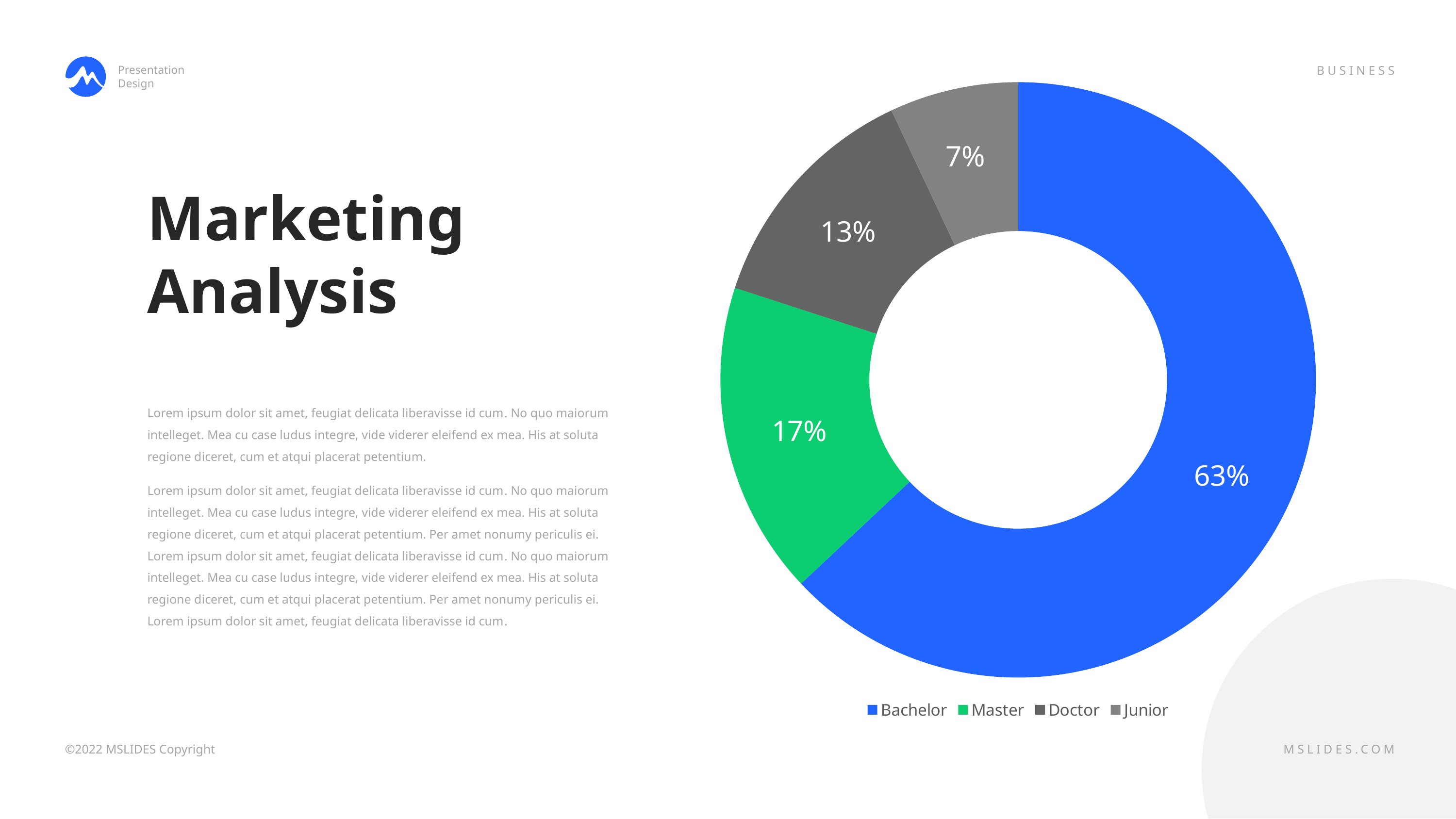
How many categories does the chart show? 4 What share of the doughnut chart does Bachelor represent? 63% What is the difference in percentage points between the Bachelor and Master slices? 46 What share of the doughnut chart does Doctor represent? 13% Which category has the smallest slice in the chart? Junior What is the difference in percentage points between the Doctor and Junior slices? 6 What kind of chart is shown on the slide? Doughnut chart Which slice is larger, Master or Doctor? Master Which category has the largest slice in the chart? Bachelor What share of the doughnut chart does Junior represent? 7% What share of the doughnut chart does Master represent? 17% What colour is the Master slice in the chart? Green